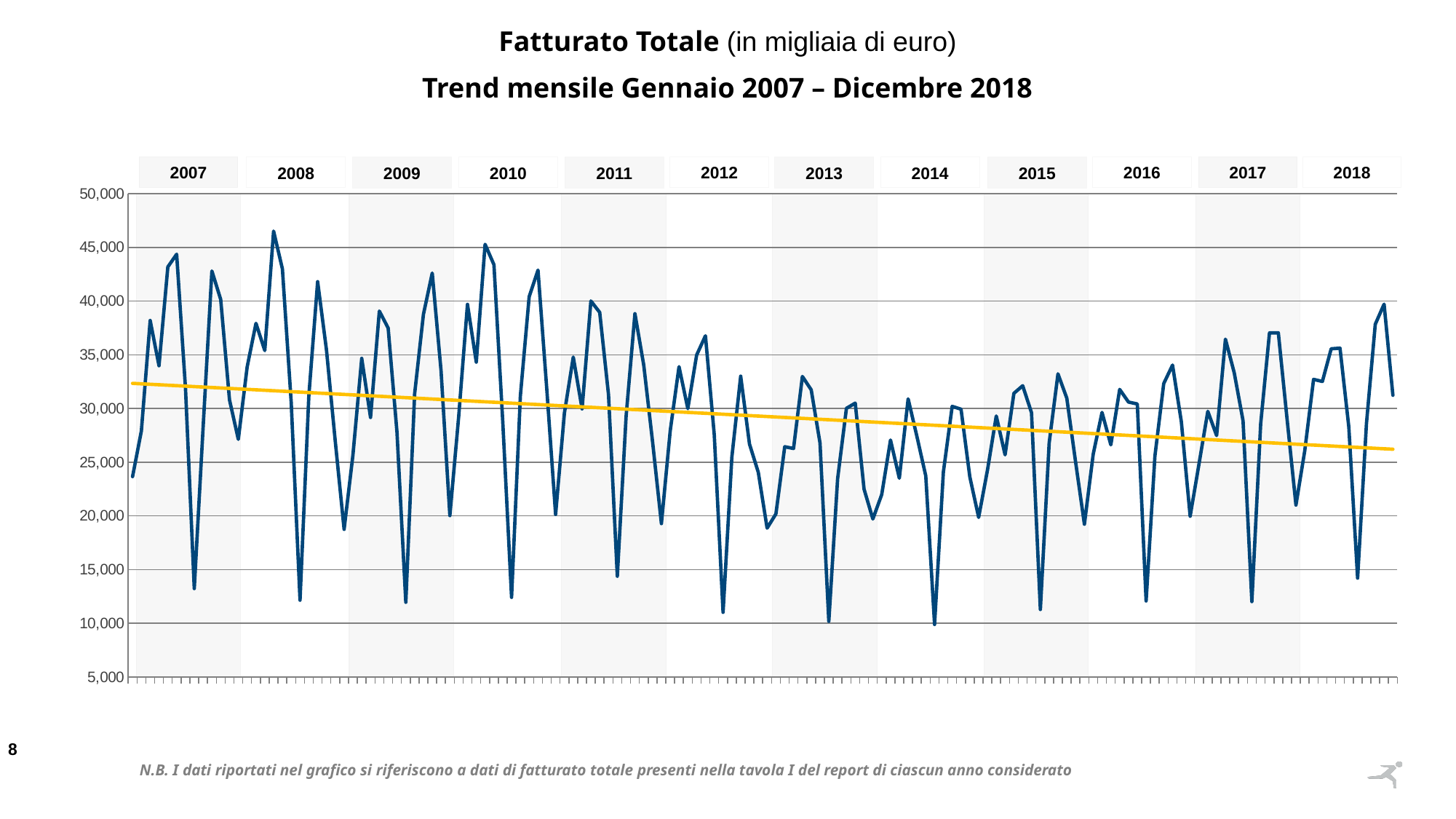
What kind of chart is shown on the slide? line chart How many years are labelled along the top of the chart? 12 Does the yellow trend line rise or fall from 2007 to 2018? fall What is the title of the chart? Fatturato Totale (in migliaia di euro) – Trend mensile Gennaio 2007 – Dicembre 2018 Is the lowest point in 2008 greater or less than 15,000? less Is the lowest point in 2012 greater or less than 10,000? greater Is the highest peak in 2017 greater or less than 35,000? greater What is the maximum value shown on the vertical axis? 50,000 Which is higher, the highest peak in 2007 or the highest peak in 2014? 2007 In which year does the blue line reach its highest peak? 2008